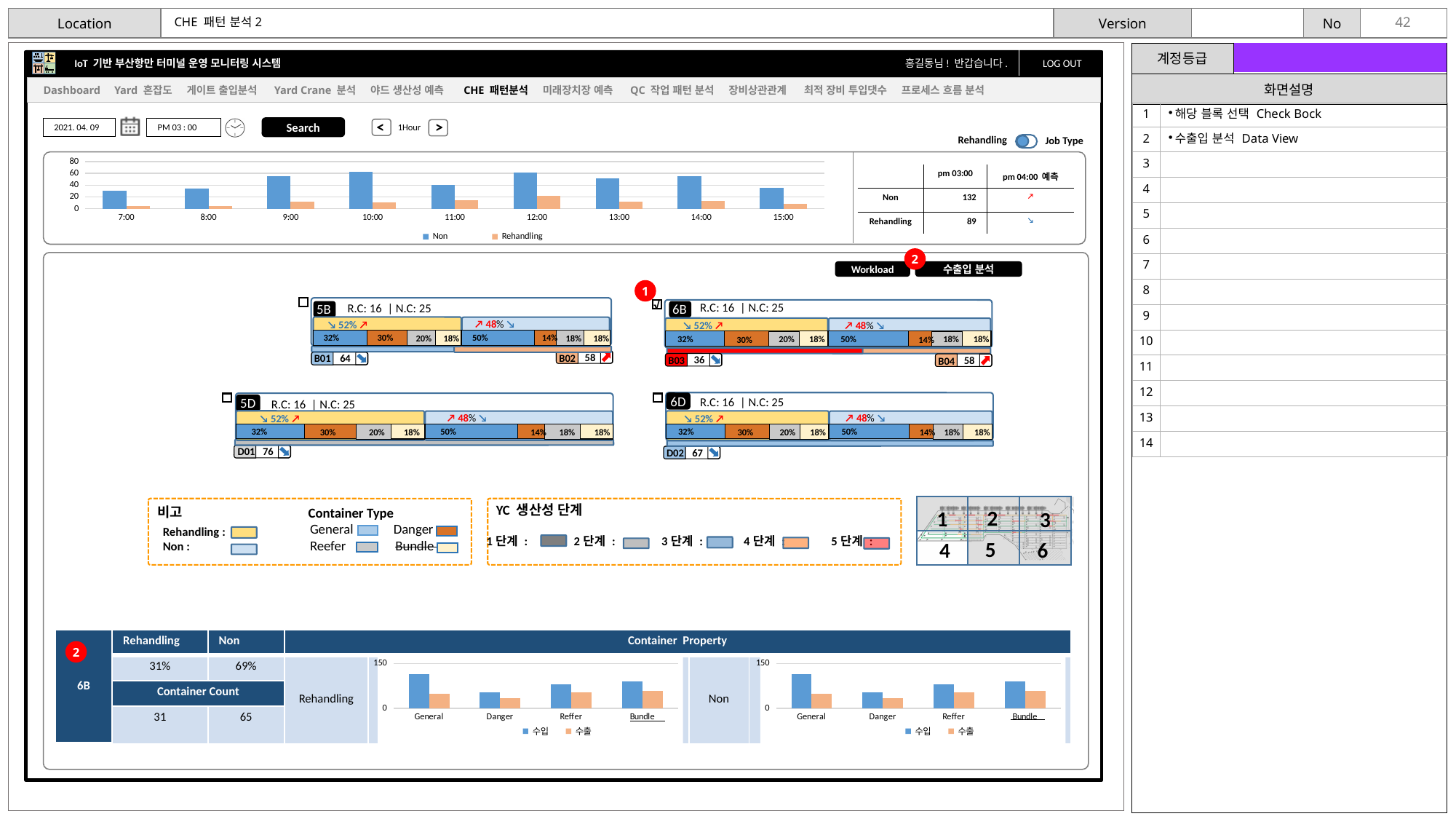
In the top chart, is the Non value at 10:00 greater or less than 40? greater In the top chart, how many series does the legend list? 2 In the top chart, at which hour is the Rehandling bar highest? 12:00 In the bottom-left Rehandling chart under Container Property, how many categories are on the x axis? 4 In the top chart, how many time points are shown on the x axis? 9 In the top chart, what are the two legend entries? Non, Rehandling In the top chart, is the Rehandling value at 7:00 greater or less than 20? less In the bottom-right Non chart under Container Property, which is larger for Danger, 수입 or 수출? 수입 In the bottom-right Non chart under Container Property, which category has the highest 수입 bar? General In the top chart, which series has the larger value at 12:00, Non or Rehandling? Non In the bottom-left Rehandling chart under Container Property, what are the legend entries? 수입, 수출 What kind of chart is the top chart showing Non and Rehandling by hour? bar chart